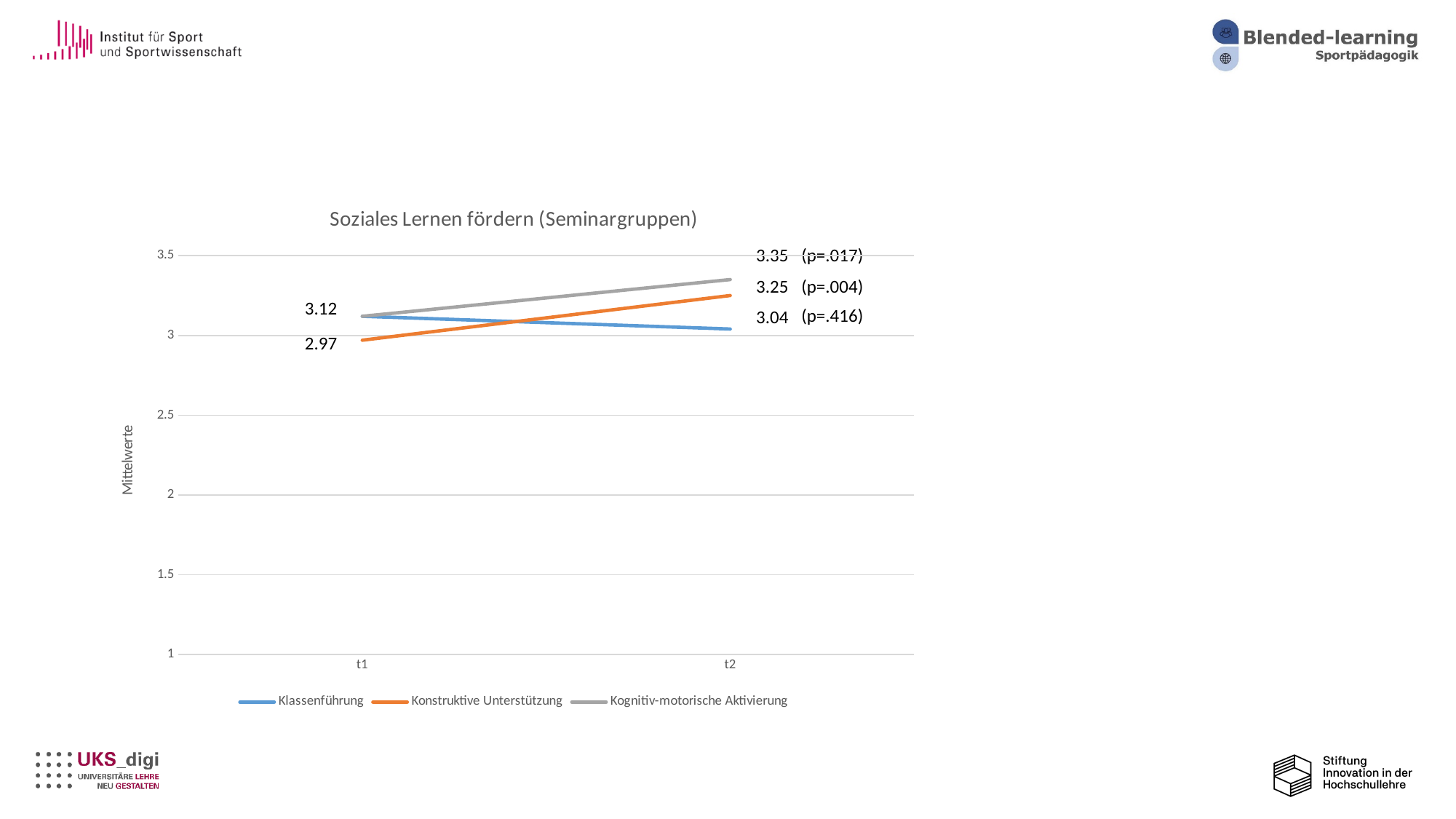
What is the title of the chart? Soziales Lernen fördern (Seminargruppen) What kind of chart is shown on the slide? line chart What is the value for Klassenführung at t2? 3.04 What is the value for Konstruktive Unterstützung at t2? 3.25 By how much does Konstruktive Unterstützung increase from t1 to t2? 0.28 Does the value for Klassenführung rise or fall from t1 to t2? fall What is the value for Kognitiv-motorische Aktivierung at t2? 3.35 Which series has the highest value at t2? Kognitiv-motorische Aktivierung How many series does the legend list? 3 What is the value for Konstruktive Unterstützung at t1? 2.97 Which series has the lowest value at t2? Klassenführung How many time points are shown on the x axis? 2